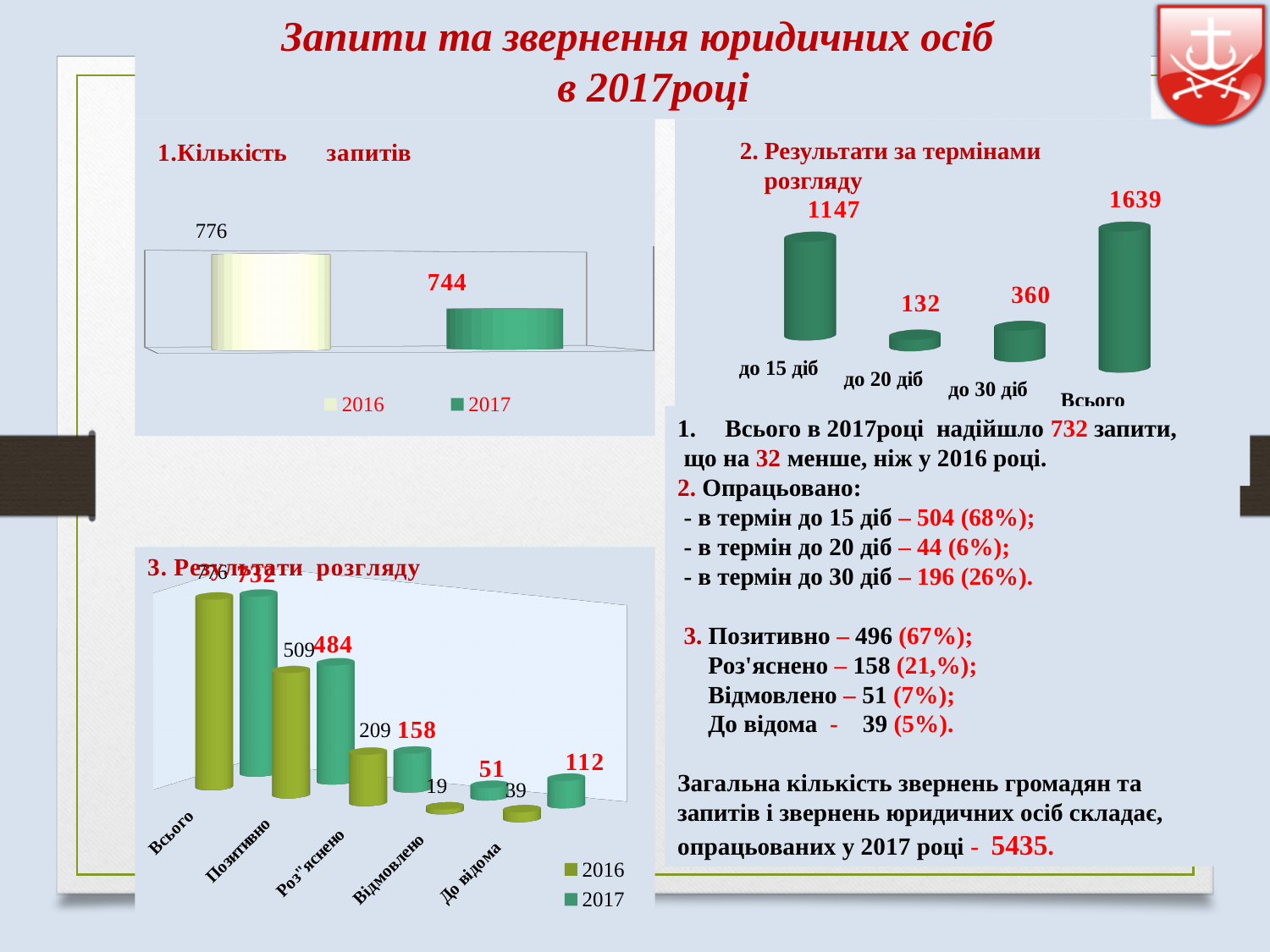
In the chart titled "1.Кількість запитів", what is the difference between the 2016 and 2017 values? 32 In the chart titled "3. Результати розгляду", what is the 2016 value for "Роз'яснено"? 209 In the chart titled "2. Результати за термінами розгляду", how many categories are shown? 4 In the chart titled "2. Результати за термінами розгляду", which category has the lowest value? до 20 діб In the chart titled "2. Результати за термінами розгляду", what is the difference between "до 30 діб" and "до 20 діб"? 228 In the chart titled "1.Кількість запитів", what is the value for 2017? 744 What kind of chart is the chart titled "3. Результати розгляду"? Bar chart In the chart titled "3. Результати розгляду", which is larger for "До відома": the 2016 value or the 2017 value? 2017 In the chart titled "2. Результати за термінами розгляду", what is the value for "до 15 діб"? 1147 In the chart titled "1.Кількість запитів", what is the value for 2016? 776 In the chart titled "3. Результати розгляду", how many series does the legend list? 2 In the chart titled "3. Результати розгляду", what is the 2017 value for "Позитивно"? 484